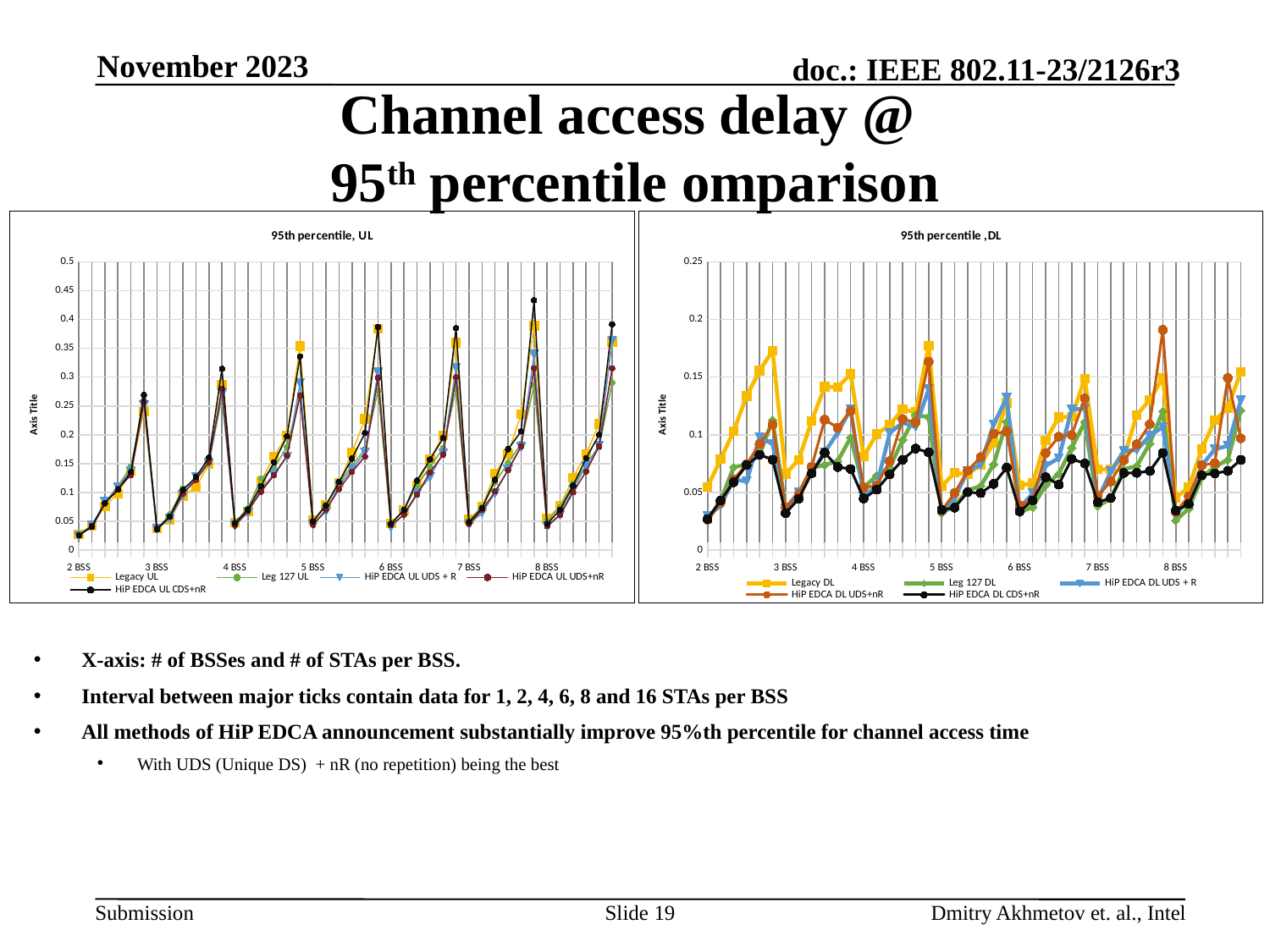
In the "95th percentile ,DL" chart, is the highest value of the HiP EDCA DL CDS+nR series greater or less than 0.1? less What kind of chart is the "95th percentile ,DL" chart on the right? Line chart How many BSS categories are labelled on the x axis of the "95th percentile, UL" chart? 7 In the "95th percentile, UL" chart, is the peak of the Legacy UL series within the 5 BSS interval greater or less than 0.3? greater What kind of chart is the "95th percentile, UL" chart on the left? Line chart What is the maximum value shown on the y axis of the "95th percentile ,DL" chart? 0.25 What is the maximum value shown on the y axis of the "95th percentile, UL" chart? 0.5 How many series does the legend of the "95th percentile, UL" chart list? 5 How many series does the legend of the "95th percentile ,DL" chart list? 5